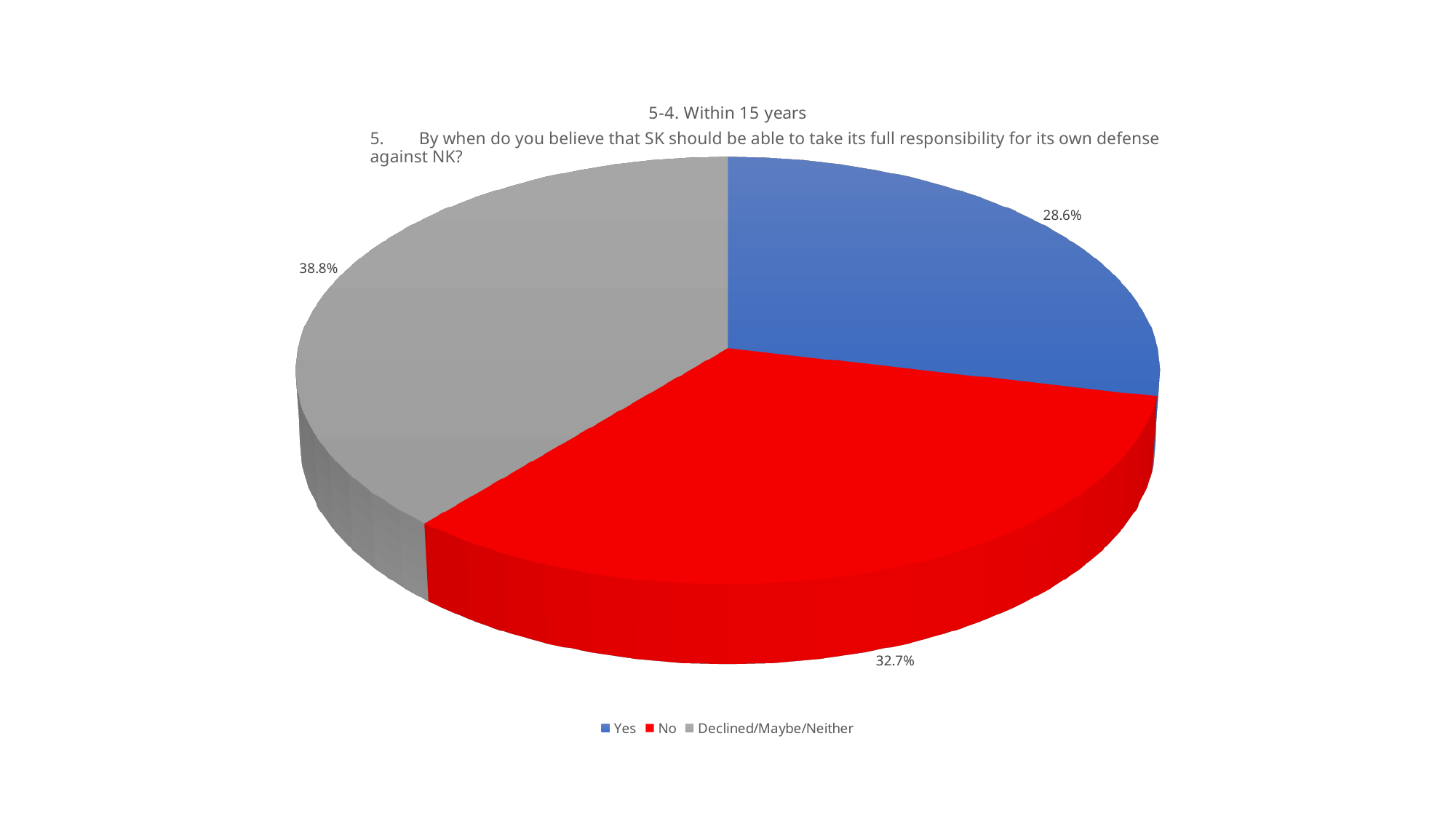
What is the difference between the No share and the Yes share? 4.1% Which category has the smallest share of the pie? Yes What is the value for No? 32.7% What is the value for Yes? 28.6% How many slices does the pie chart have? 3 Which category has the largest share of the pie? Declined/Maybe/Neither Which is larger, the share for Yes or the share for No? No What is the title of the chart? 5-4. Within 15 years Which colour represents the No slice? red What is the difference between the Declined/Maybe/Neither share and the No share? 6.1% What is the value for Declined/Maybe/Neither? 38.8% What kind of chart is shown on the slide? pie chart